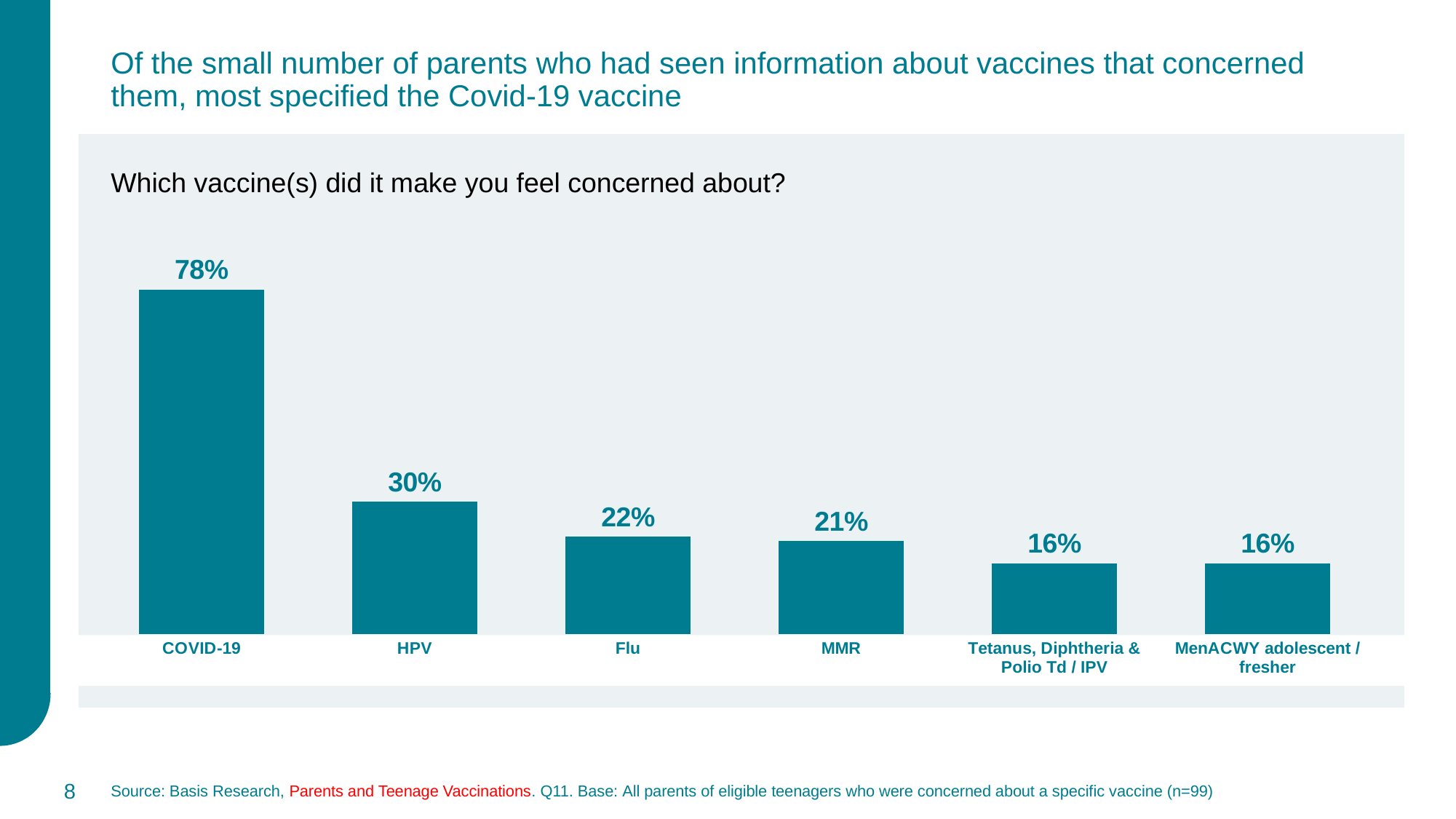
What is the value shown for Tetanus, Diphtheria & Polio Td / IPV? 16% What is the difference between the values for COVID-19 and HPV? 48% Which has a larger value, HPV or Flu? HPV How many vaccine categories are shown in the chart? 6 What is the value shown for MMR? 21% What is the difference between the values for Flu and MMR? 1% What is the value shown for HPV? 30% Which vaccine has the highest percentage of concerned parents? COVID-19 What question is the chart based on, as shown above the chart? Which vaccine(s) did it make you feel concerned about? What percentage of parents said the information made them feel concerned about the COVID-19 vaccine? 78% What kind of chart is shown on the slide? Bar chart Do the values rise or fall moving from left to right across the categories? Fall